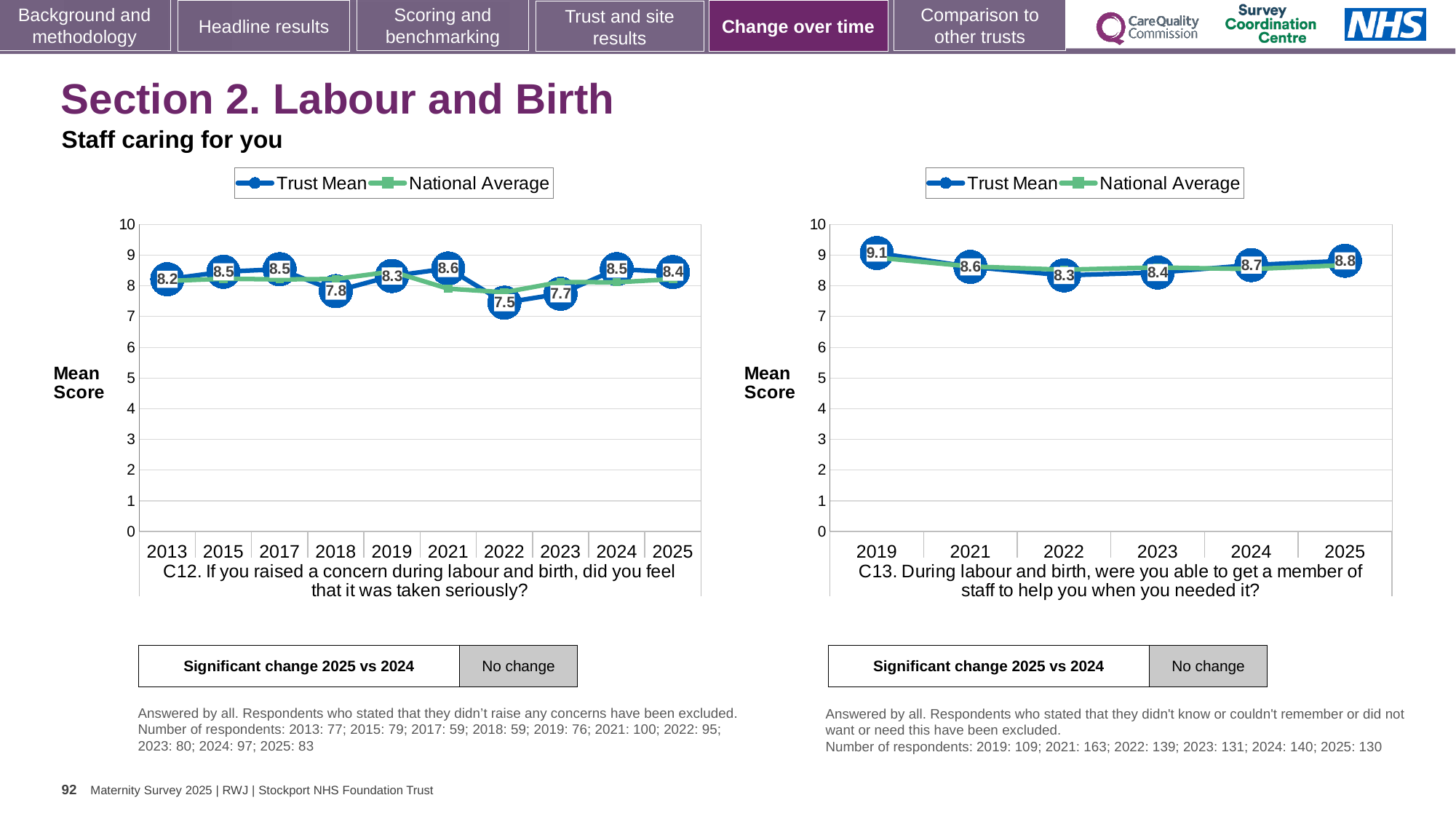
In the C12 chart (left), what is the difference between the Trust Mean scores for 2021 and 2022? 1.1 In the C12 chart (left), how many years are plotted on the x axis? 10 In the C12 chart (left), which year has the lowest Trust Mean score? 2022 In the C13 chart (right), what is the Trust Mean score for 2019? 9.1 In the C12 chart (left), what is the Trust Mean score for 2022? 7.5 In the C13 chart (right), which year has the lowest Trust Mean score? 2022 In the C12 chart (left), what is the Trust Mean score for 2025? 8.4 In the C13 chart (right), is the National Average for 2022 greater or less than 7? greater In the C13 chart (right), is the Trust Mean score for 2024 larger or smaller than for 2025? smaller What kind of chart is the C12 chart (left)? Line chart In the C12 chart (left), which year has the highest Trust Mean score? 2021 How many series does the legend of the C13 chart (right) list? 2